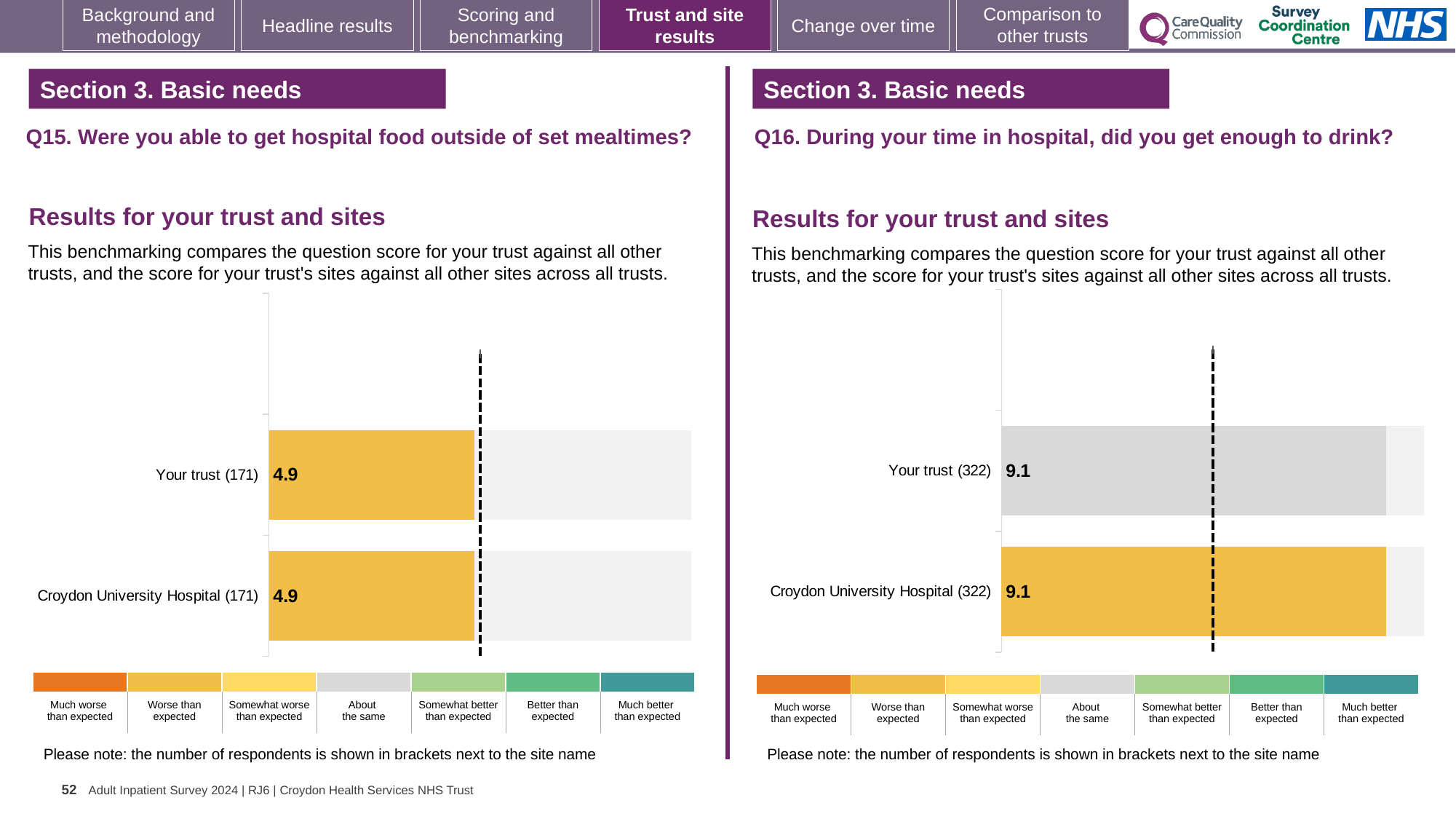
How many benchmark categories does the colour key below the Q15 chart on the left list? 7 In the Q16 chart on the right, which benchmark category does the grey colour of the Your trust bar correspond to in the key? About the same In the Q15 chart on the left, what is the difference between the score for Your trust and the score for Croydon University Hospital? 0 What type of chart is used for the Q15 results on the left? Bar chart In the Q16 chart on the right, what is the score for Your trust (322)? 9.1 In the Q16 chart on the right, what is the difference between the score for Your trust and the score for Croydon University Hospital? 0 How many respondents are shown in brackets for Your trust in the Q16 chart on the right? 322 How many bars are plotted in the Q15 chart on the left? 2 In the Q15 chart on the left, what is the score for Your trust (171)? 4.9 In the Q15 chart on the left, what is the score for Croydon University Hospital (171)? 4.9 In the Q16 chart on the right, what is the score for Croydon University Hospital (322)? 9.1 How many bars are plotted in the Q16 chart on the right? 2